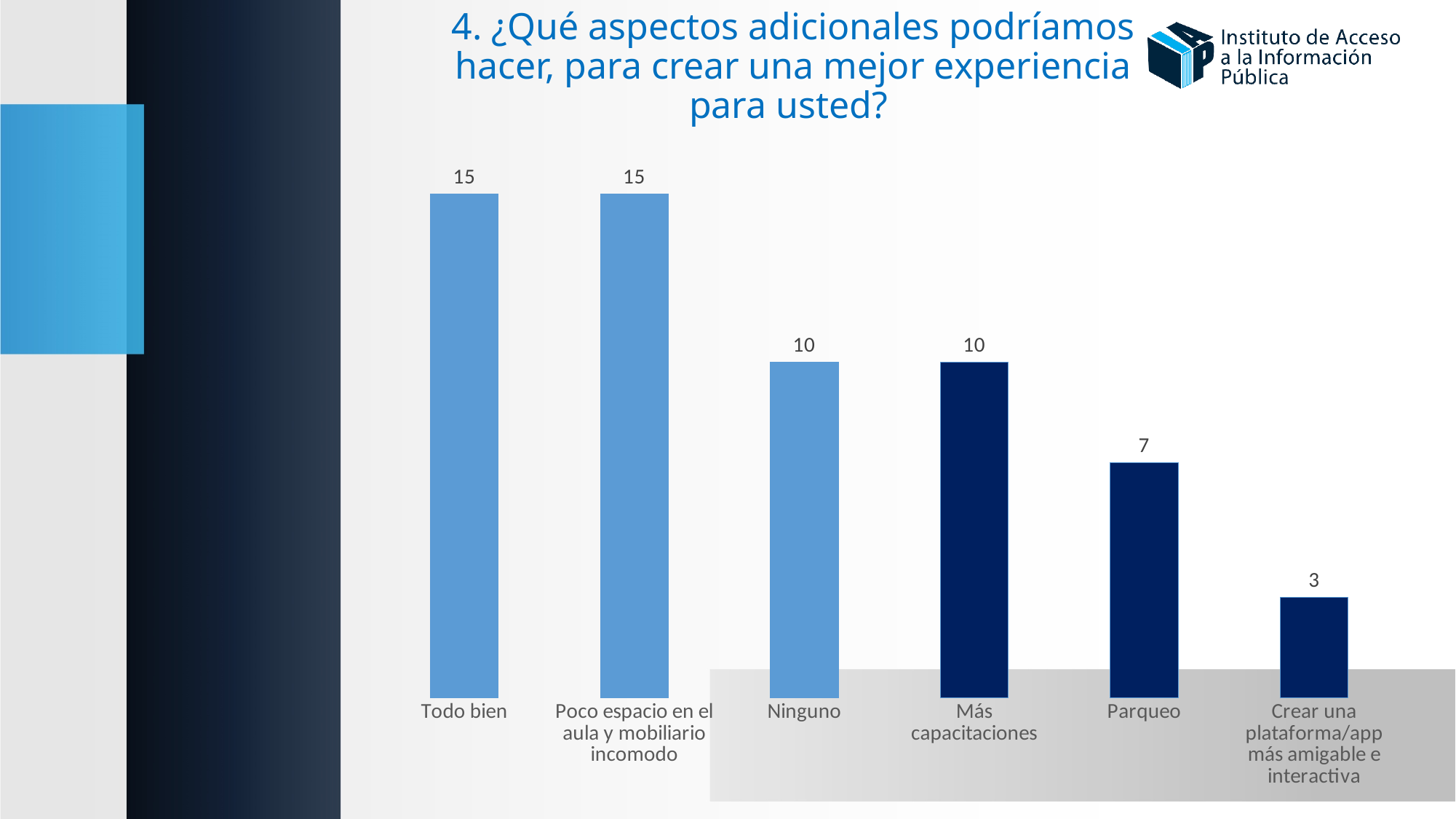
Do the values rise or fall from left to right across the categories? Fall Which is larger, the value for Poco espacio en el aula y mobiliario incomodo or the value for Parqueo? Poco espacio en el aula y mobiliario incomodo What is the value for Todo bien? 15 What is the total of the values for Todo bien and Poco espacio en el aula y mobiliario incomodo? 30 What is the difference between the values for Todo bien and Parqueo? 8 What is the value for Más capacitaciones? 10 What is the value for Parqueo? 7 What kind of chart is shown on the slide? Bar chart What is the value for Crear una plataforma/app más amigable e interactiva? 3 What is the difference between the values for Ninguno and Crear una plataforma/app más amigable e interactiva? 7 Which category has the lowest value? Crear una plataforma/app más amigable e interactiva How many categories are shown in the chart? 6